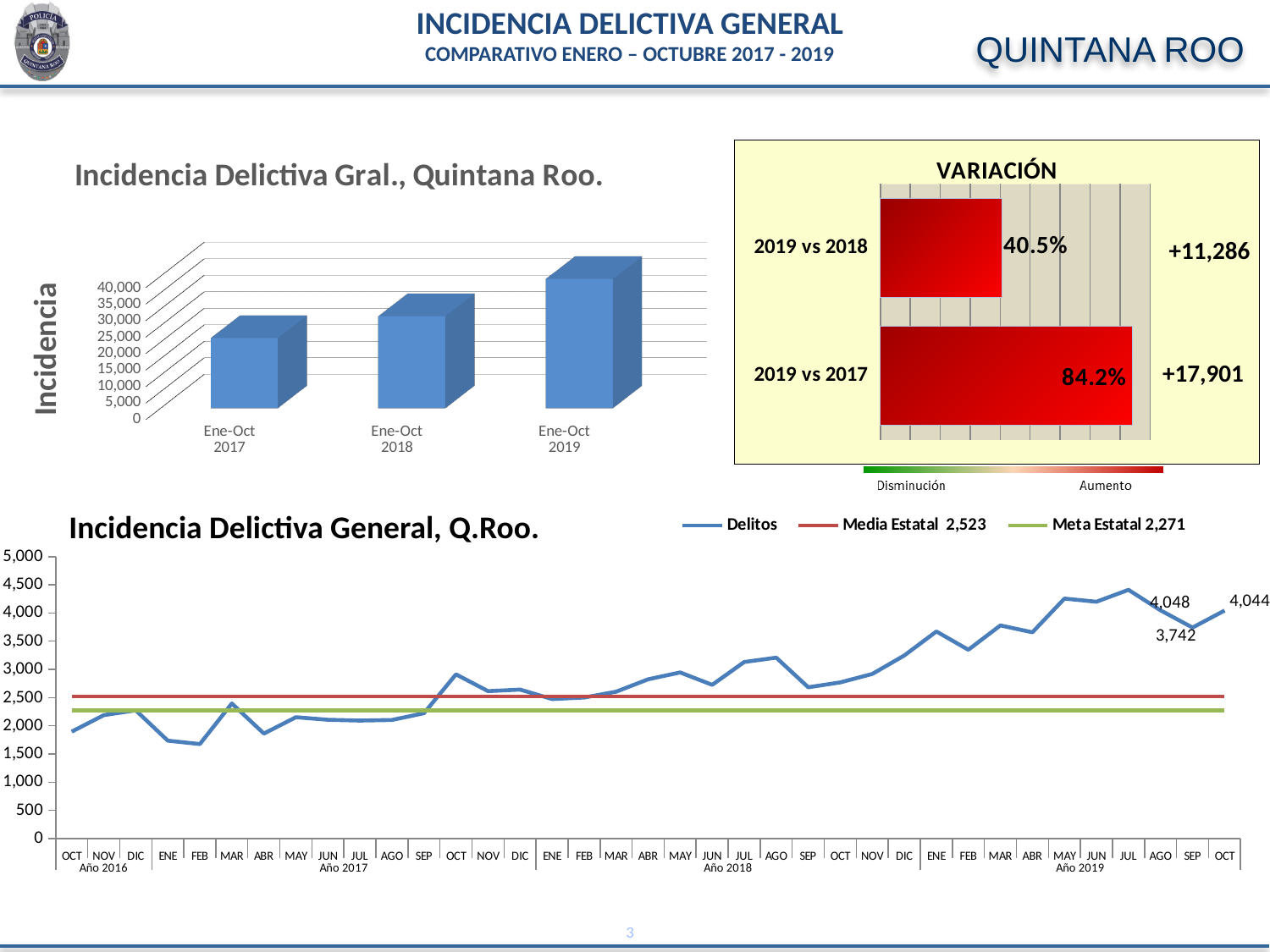
In the VARIACIÓN chart, which comparison has the larger percentage variation? 2019 vs 2017 In the VARIACIÓN chart, what absolute change is shown next to the 2019 vs 2017 bar? +17,901 In the line chart 'Incidencia Delictiva General, Q.Roo.', what value does the legend give for Meta Estatal? 2,271 In the line chart 'Incidencia Delictiva General, Q.Roo.', what is the Delitos value for SEP of Año 2019? 3,742 In the line chart 'Incidencia Delictiva General, Q.Roo.', what is the Delitos value for OCT of Año 2019? 4,044 In the line chart 'Incidencia Delictiva General, Q.Roo.', what is the difference between the Delitos values for OCT 2019 and SEP 2019? 302 In the chart 'Incidencia Delictiva Gral., Quintana Roo.', is the value for Ene-Oct 2017 greater or less than 25,000? less In the line chart 'Incidencia Delictiva General, Q.Roo.', how many series does the legend list? 3 In the VARIACIÓN chart, what is the percentage shown for 2019 vs 2017? 84.2% In the chart 'Incidencia Delictiva Gral., Quintana Roo.', which period has the highest bar? Ene-Oct 2019 In the VARIACIÓN chart, what is the percentage shown for 2019 vs 2018? 40.5% In the VARIACIÓN chart, what is the difference in percentage points between 2019 vs 2017 and 2019 vs 2018? 43.7